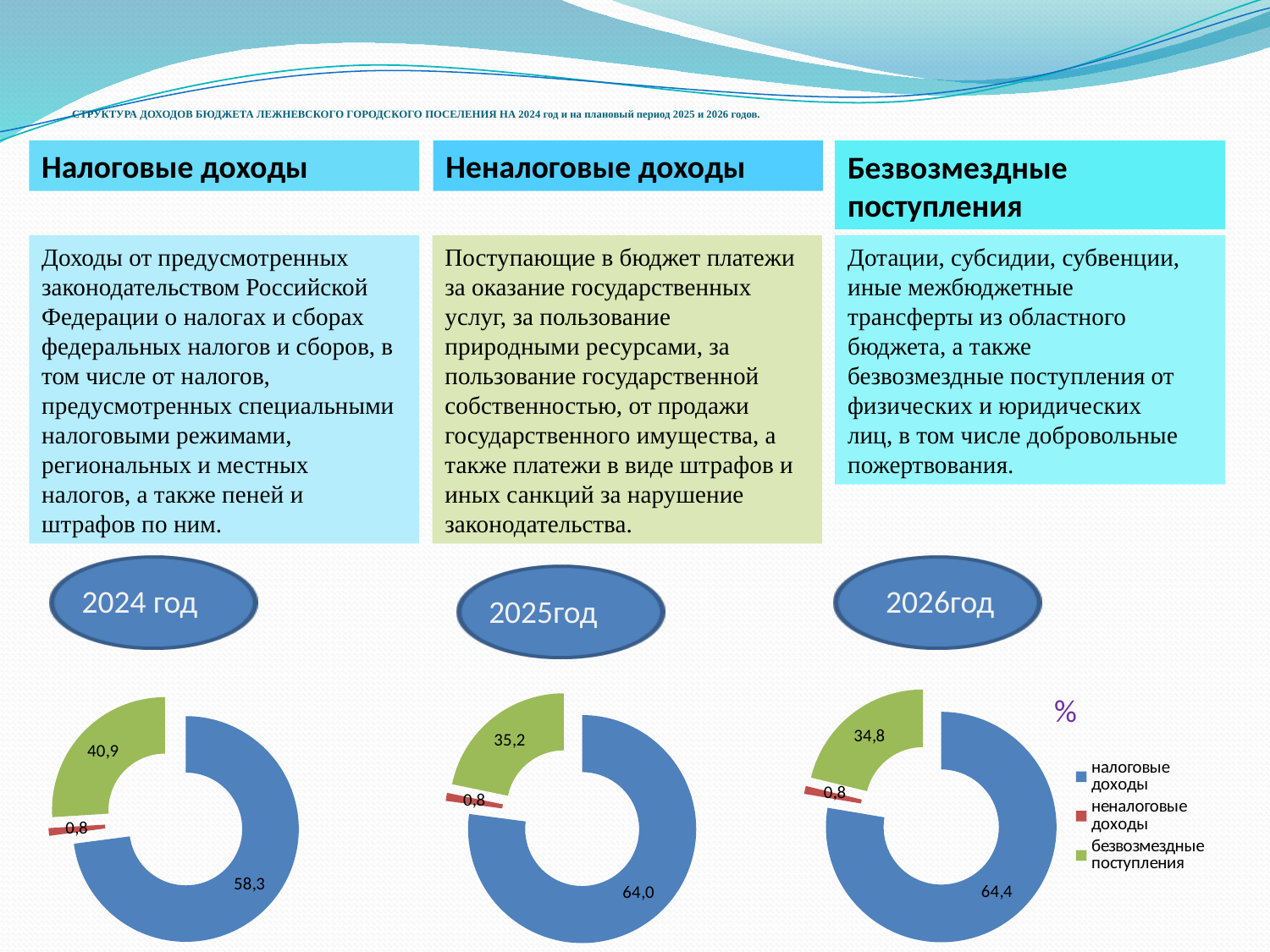
In the 2025год chart, what is the value for налоговые доходы? 64,0 In the 2024 год chart, which category has the smallest value? неналоговые доходы In the 2024 год chart, what is the difference between налоговые доходы and безвозмездные поступления? 17,4 In the 2026год chart, what is the difference between налоговые доходы and безвозмездные поступления? 29,6 In the 2026год chart, what is the value for безвозмездные поступления? 34,8 Which is larger: безвозмездные поступления in the 2024 год chart or in the 2025год chart? 2024 год How many series does the legend list for the charts? 3 In the 2024 год chart, what is the value for налоговые доходы? 58,3 In the 2026год chart, what is the value for неналоговые доходы? 0,8 What kind of chart is used for the 2025год chart? doughnut chart In the 2025год chart, which category has the largest value? налоговые доходы In the 2024 год chart, what is the value for безвозмездные поступления? 40,9